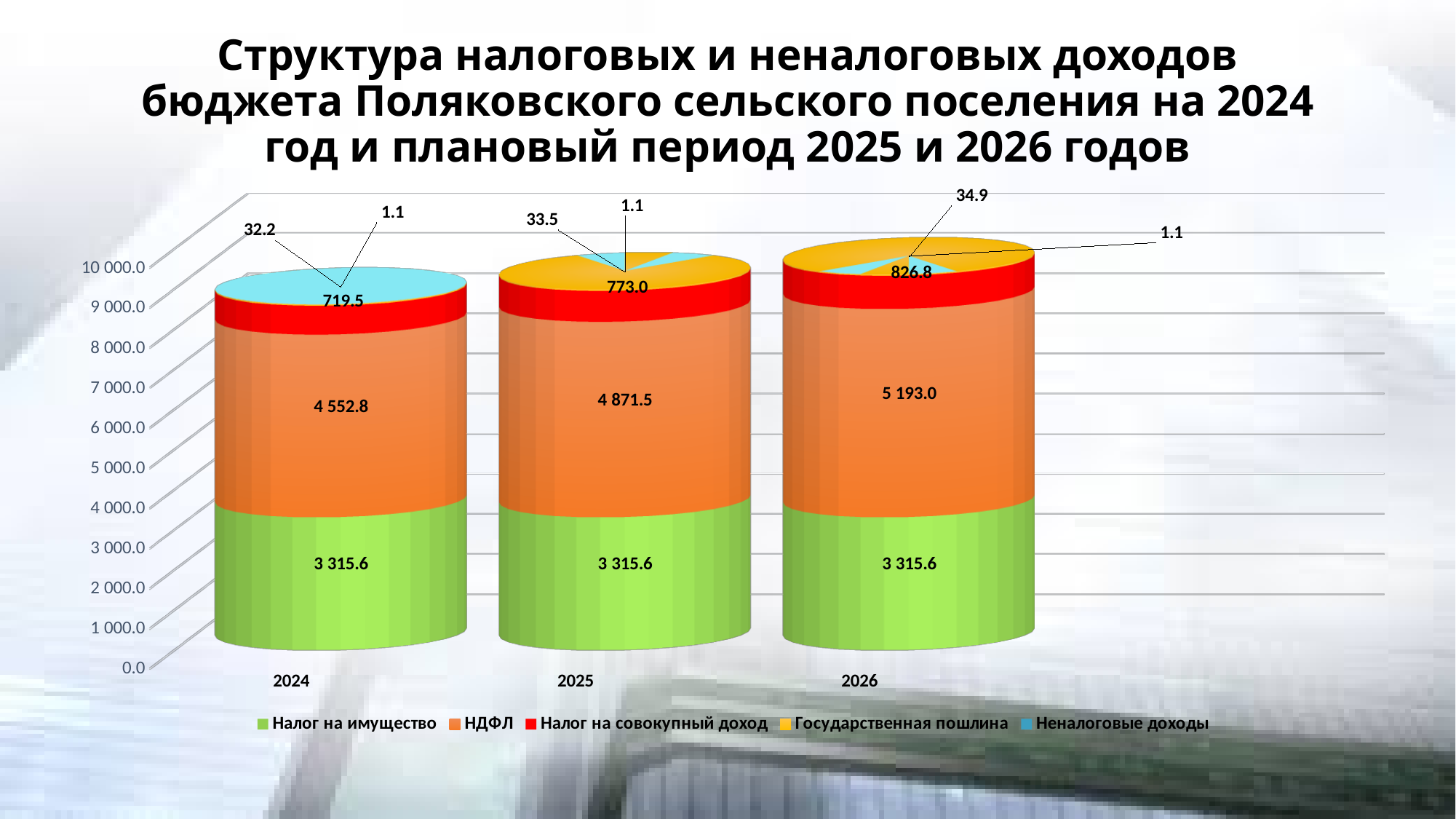
In which year is НДФЛ the highest? 2026 What is the value of Налог на совокупный доход for 2026? 826.8 How many series does the legend list? 5 Does the value of НДФЛ rise or fall from 2024 to 2026? rise What is the difference between Налог на совокупный доход in 2026 and in 2025? 53.8 What is the value of Налог на имущество for 2025? 3 315.6 What kind of chart is shown on the slide? stacked bar chart What is the value of НДФЛ for 2026? 5 193.0 How many years are shown on the x axis? 3 By how much does НДФЛ in 2026 exceed НДФЛ in 2024? 640.2 What is the value of НДФЛ for 2024? 4 552.8 Which is larger in 2025: НДФЛ or Налог на имущество? НДФЛ